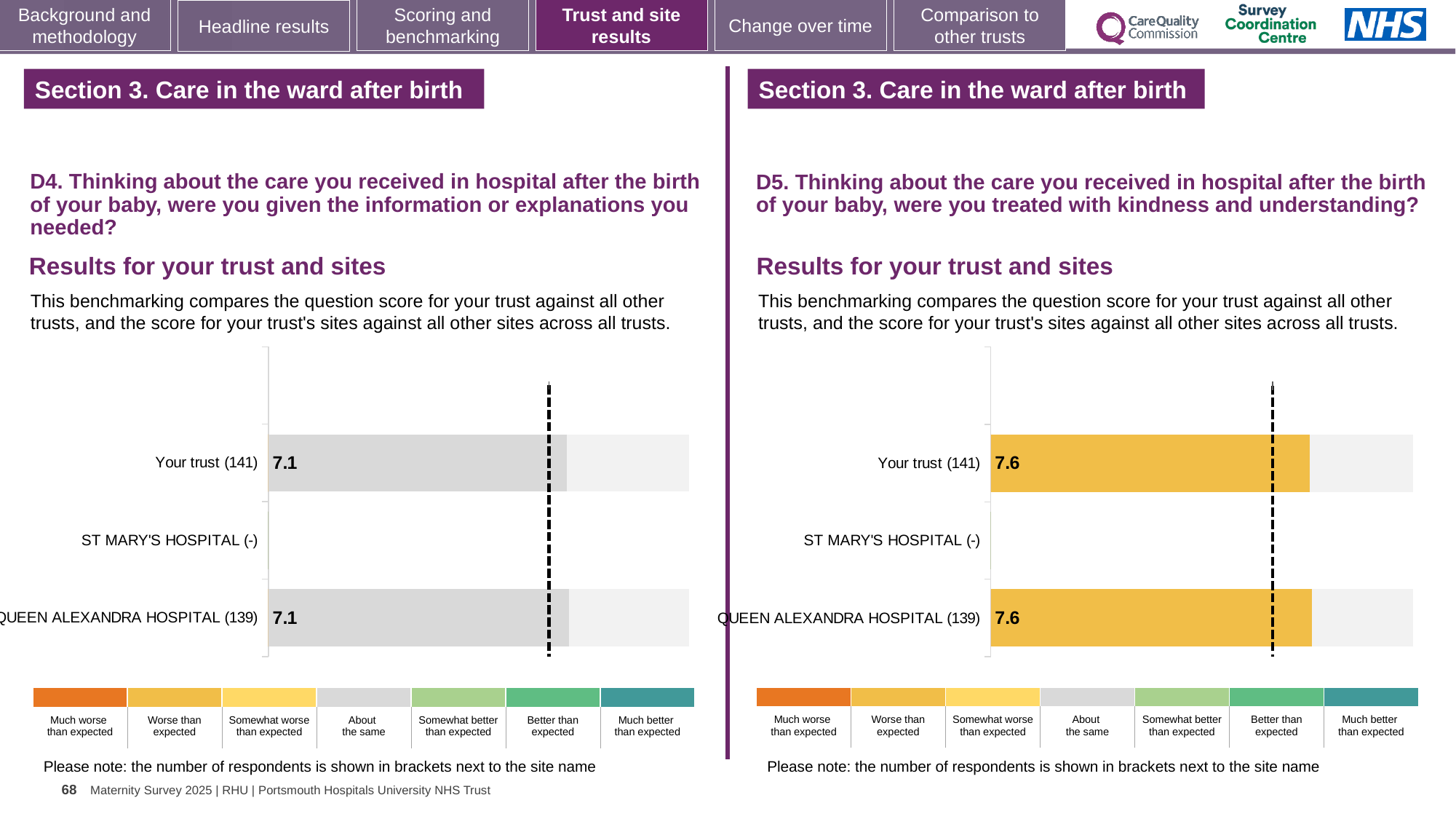
On the D4 chart (left), what is the score for Your trust (141)? 7.1 On the D4 chart (left), what is the score for QUEEN ALEXANDRA HOSPITAL (139)? 7.1 How many site/trust categories are listed on the D5 chart (right)? 3 On the D4 chart (left), which category has no bar plotted? ST MARY'S HOSPITAL (-) On the D5 chart (right), what is the score for QUEEN ALEXANDRA HOSPITAL (139)? 7.6 On the D4 chart (left), what is the difference between the scores for Your trust (141) and QUEEN ALEXANDRA HOSPITAL (139)? 0 On the D5 chart (right), what is the score for Your trust (141)? 7.6 What is the difference between the Your trust score on the D5 chart (right) and the Your trust score on the D4 chart (left)? 0.5 Is the score for Your trust on the D5 chart (right) larger or smaller than the score for Your trust on the D4 chart (left)? Larger What kind of chart is the D4 chart on the left? Bar chart How many benchmark categories does the colour key below the D4 chart (left) list? 7